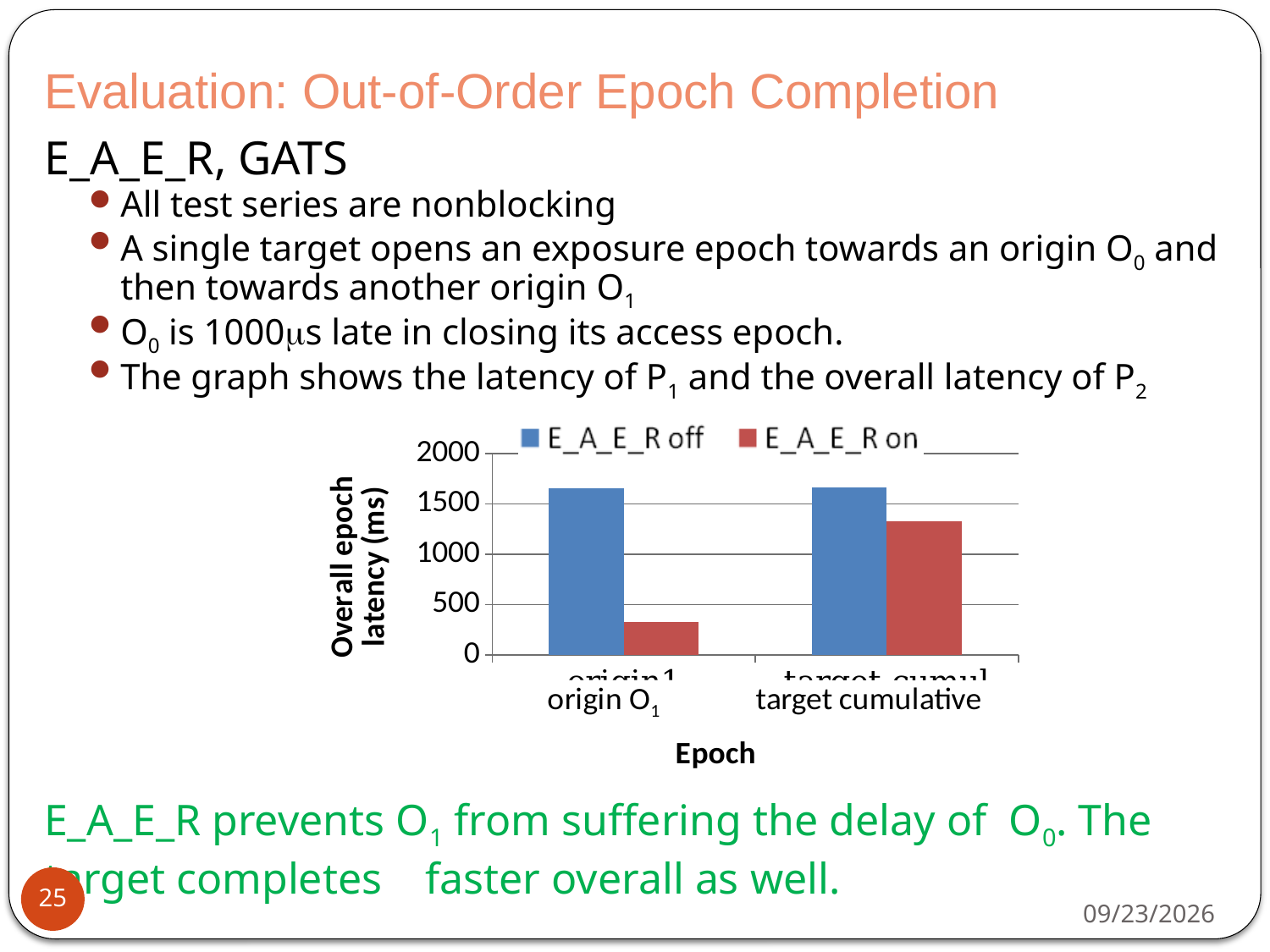
What are the two series named in the chart's legend? E_A_E_R off and E_A_E_R on What is the title of the chart's vertical axis? Overall epoch latency (ms) What kind of chart is shown on the slide? bar chart Is the E_A_E_R off value for origin O1 greater or less than 1500? greater How many categories are shown on the x axis of the chart? 2 How many series does the chart's legend list? 2 For the E_A_E_R on series, which category has the larger value, origin O1 or target cumulative? target cumulative For origin O1, which series has the larger value, E_A_E_R off or E_A_E_R on? E_A_E_R off Is the E_A_E_R on value for target cumulative greater or less than 1000? greater Which bar in the chart is the lowest? E_A_E_R on for origin O1 Is the E_A_E_R on value for origin O1 greater or less than 500? less